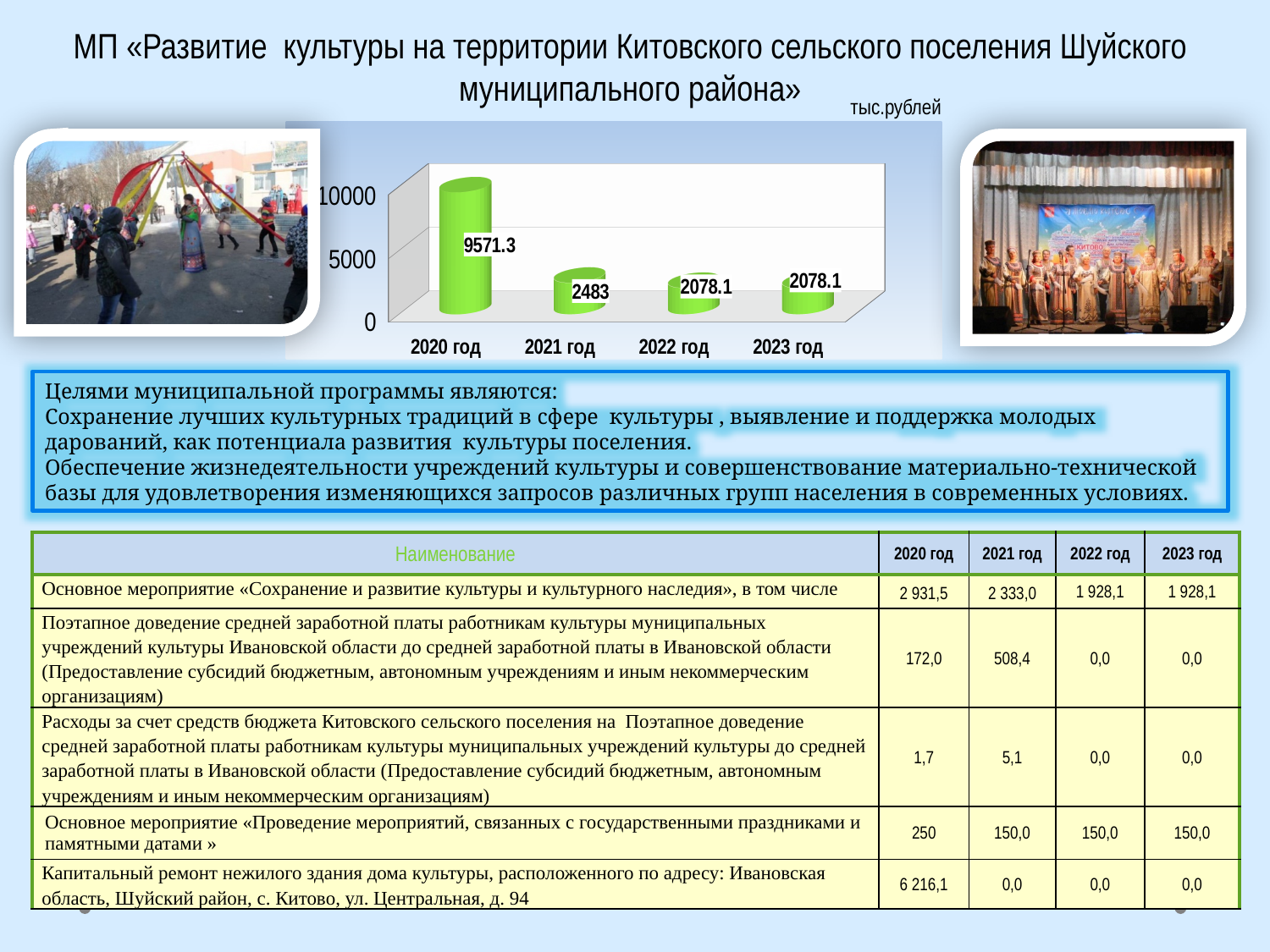
How many years are shown on the chart? 4 Do the values rise or fall from 2020 год to 2022 год? fall Which year has the highest value? 2020 год Is the value for 2020 год greater or less than 5000? greater What is the value for 2022 год? 2078.1 What kind of chart is shown on the slide? bar chart What is the difference between the values for 2020 год and 2021 год? 7088.3 What is the value for 2020 год? 9571.3 What is the value for 2023 год? 2078.1 What is the value for 2021 год? 2483 Which is larger, the value for 2021 год or the value for 2023 год? 2021 год What is the difference between the values for 2021 год and 2022 год? 404.9